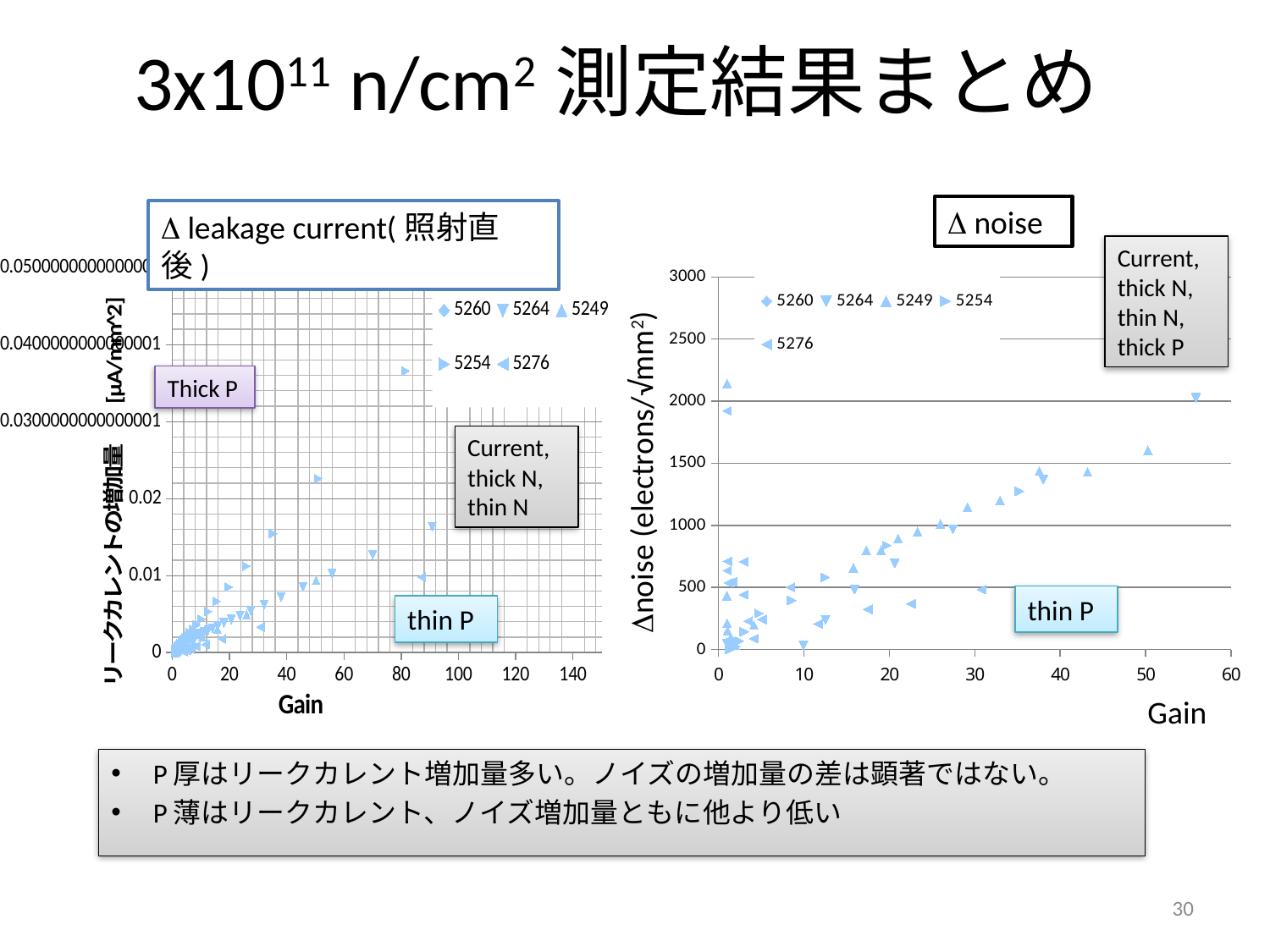
In the Δ noise chart, is the 5264 point at a Gain of about 10 greater or less than 500? less What is the highest tick value on the x axis of the Δ leakage current chart? 140 In the Δ noise chart, do the Δnoise values generally rise or fall as Gain increases? rise In the Δ leakage current chart, is the 5254 point at a Gain of about 80 greater or less than 0.02? greater How many series does the legend of the Δ leakage current chart list? 5 What kind of chart is the Δ noise chart on the right? scatter chart In the Δ noise chart, is the 5264 point at a Gain of about 56 greater or less than 1500? greater What is the y-axis title of the Δ noise chart? Δnoise (electrons/√mm²) How many series does the legend of the Δ noise chart list? 5 What kind of chart is the Δ leakage current chart on the left? scatter chart